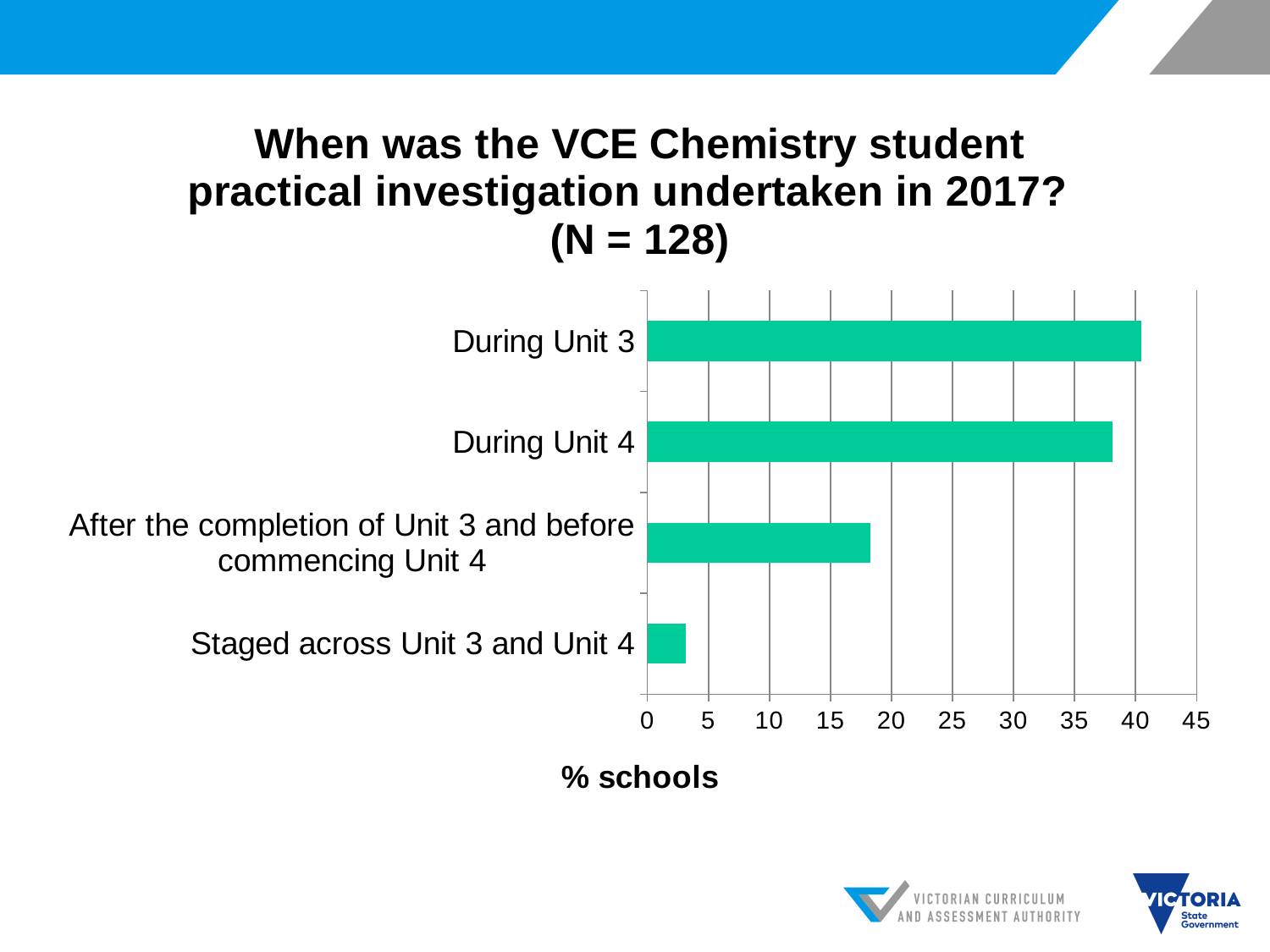
What kind of chart is shown on the slide? bar chart Is the value for During Unit 4 greater or less than 35? greater Which category has the highest value? During Unit 3 Is the value for After the completion of Unit 3 and before commencing Unit 4 greater or less than 20? less Which is larger, the value for During Unit 4 or the value for After the completion of Unit 3 and before commencing Unit 4? During Unit 4 How many categories are plotted in the chart? 4 What sample size (N) is given in the chart title? 128 Is the value for Staged across Unit 3 and Unit 4 greater or less than 5? less Which category has the lowest value? Staged across Unit 3 and Unit 4 Which is larger, the value for During Unit 3 or the value for During Unit 4? During Unit 3 What is the label on the horizontal axis of the chart? % schools